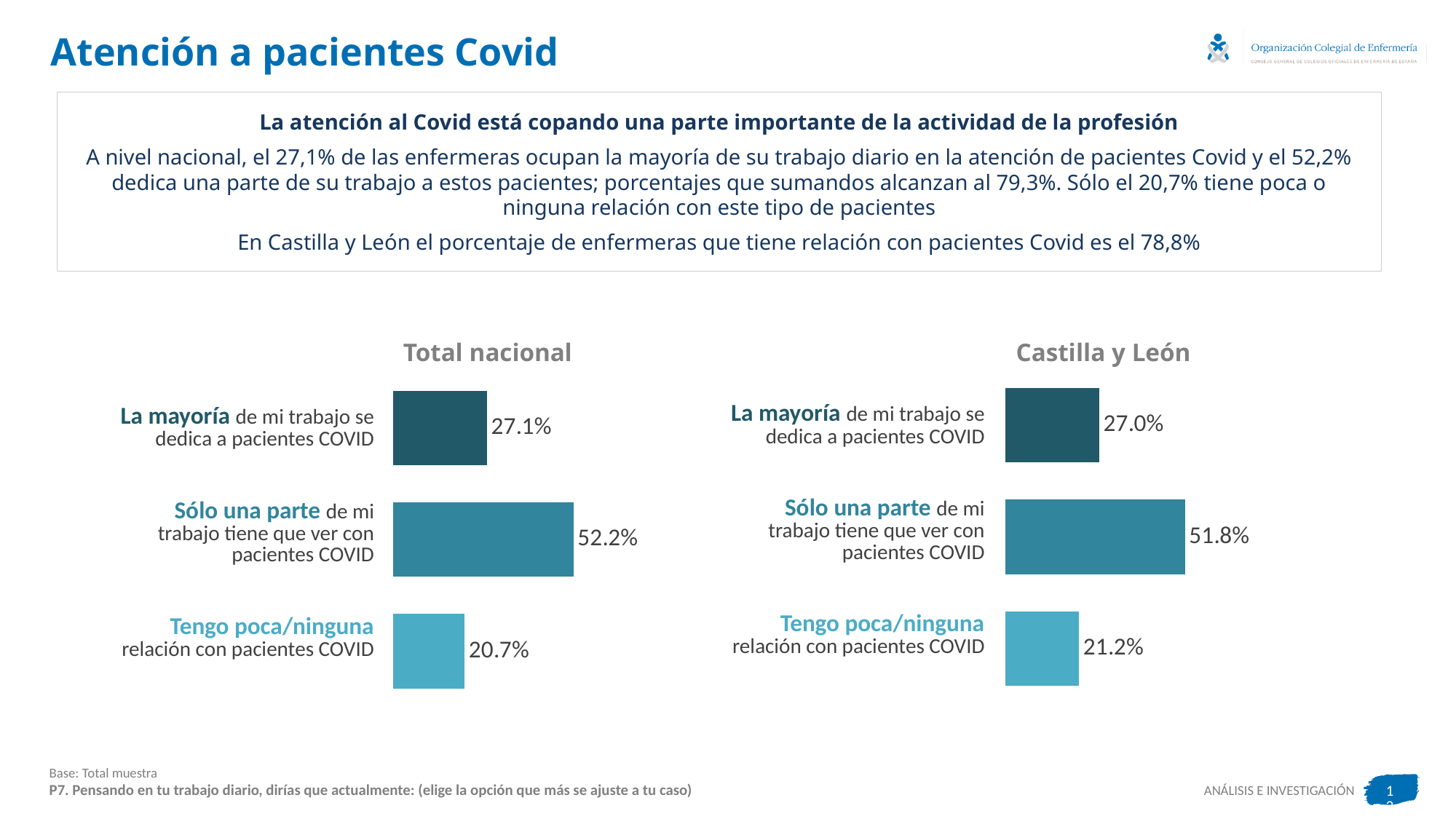
How many categories does the 'Total nacional' chart show? 3 How many charts are shown on the slide? 2 In the 'Castilla y León' chart, which category has the lowest value? Tengo poca/ninguna relación con pacientes COVID In the 'Total nacional' chart, what is the value for 'La mayoría de mi trabajo se dedica a pacientes COVID'? 27.1% In the 'Castilla y León' chart, what is the value for 'Tengo poca/ninguna relación con pacientes COVID'? 21.2% In the 'Castilla y León' chart, what is the difference between 'La mayoría' and 'Tengo poca/ninguna'? 5.8% In the 'Total nacional' chart, what is the difference between 'Sólo una parte' and 'La mayoría'? 25.1% What is the title of the chart on the right side of the slide? Castilla y León In the 'Total nacional' chart, which category has the highest value? Sólo una parte de mi trabajo tiene que ver con pacientes COVID What type of chart is the 'Castilla y León' chart? Bar chart Which is larger: 'Tengo poca/ninguna relación con pacientes COVID' in the 'Total nacional' chart or in the 'Castilla y León' chart? Castilla y León In the 'Castilla y León' chart, what is the value for 'Sólo una parte de mi trabajo tiene que ver con pacientes COVID'? 51.8%